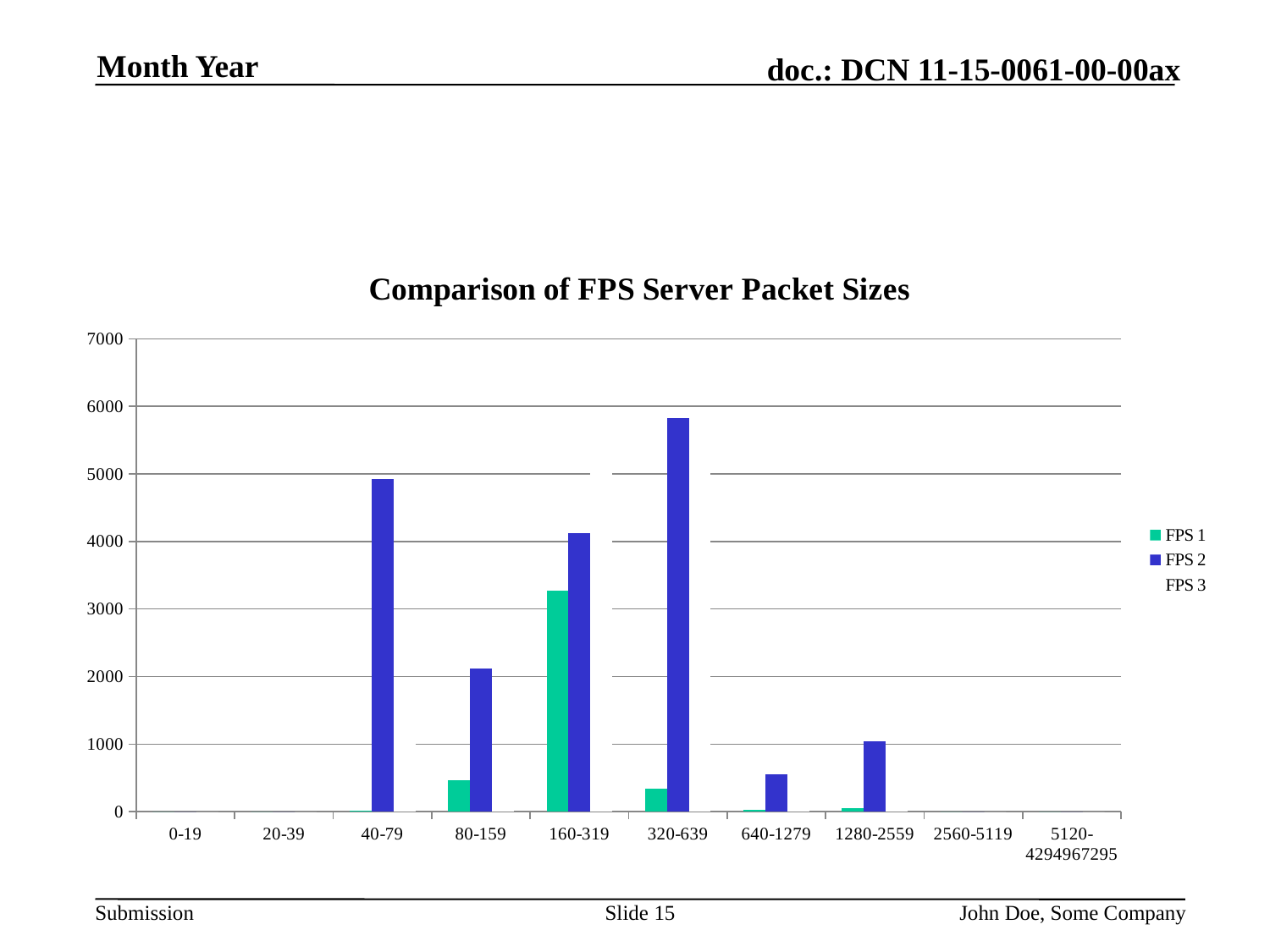
In the 160-319 category, which is larger, FPS 1 or FPS 2? FPS 2 What is the title of the chart? Comparison of FPS Server Packet Sizes For which packet size category is the FPS 2 value highest? 320-639 Is the FPS 2 value for 320-639 greater or less than 5000? greater Is the FPS 1 value for 160-319 greater or less than 3000? greater How many packet size categories are shown on the x axis? 10 Is the FPS 2 value for 640-1279 greater or less than 1000? less How many series does the legend list? 3 What kind of chart is shown on the slide? bar chart For FPS 2, which is larger, the value for 40-79 or the value for 80-159? 40-79 For which packet size category is the FPS 1 value highest? 160-319